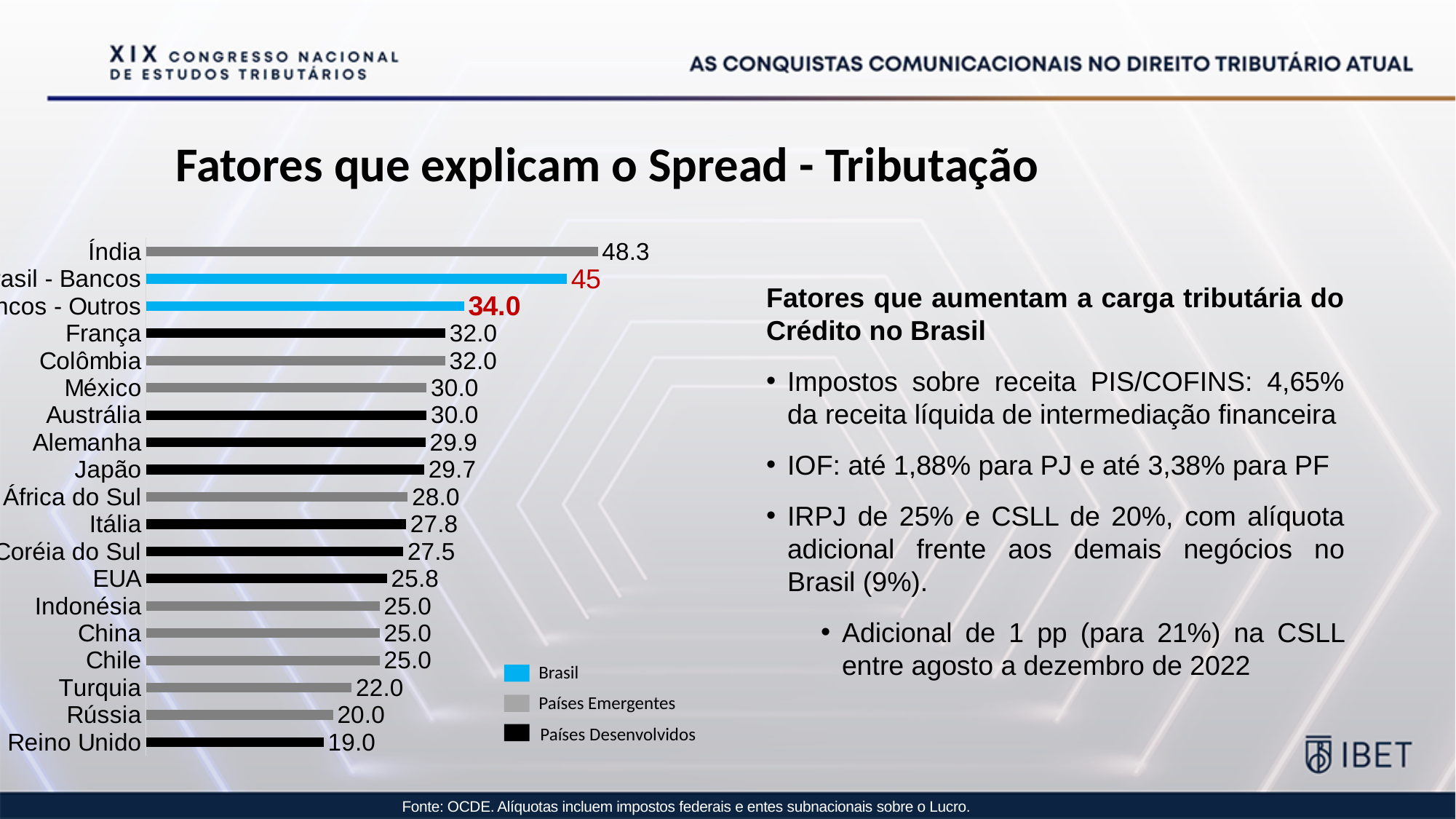
What is the value for EUA? 25.8 How many categories are plotted in the chart? 19 How many series does the legend list? 3 Which is larger, the value for Japão or the value for Itália? Japão Which category has the lowest value? Reino Unido What is the value for Reino Unido? 19.0 What is the value for Índia? 48.3 What type of chart is shown on the slide? bar chart What is the value for Alemanha? 29.9 What is the difference between the values for Índia and Reino Unido? 29.3 Which category has the highest value? Índia What is the difference between the values for França and Turquia? 10.0